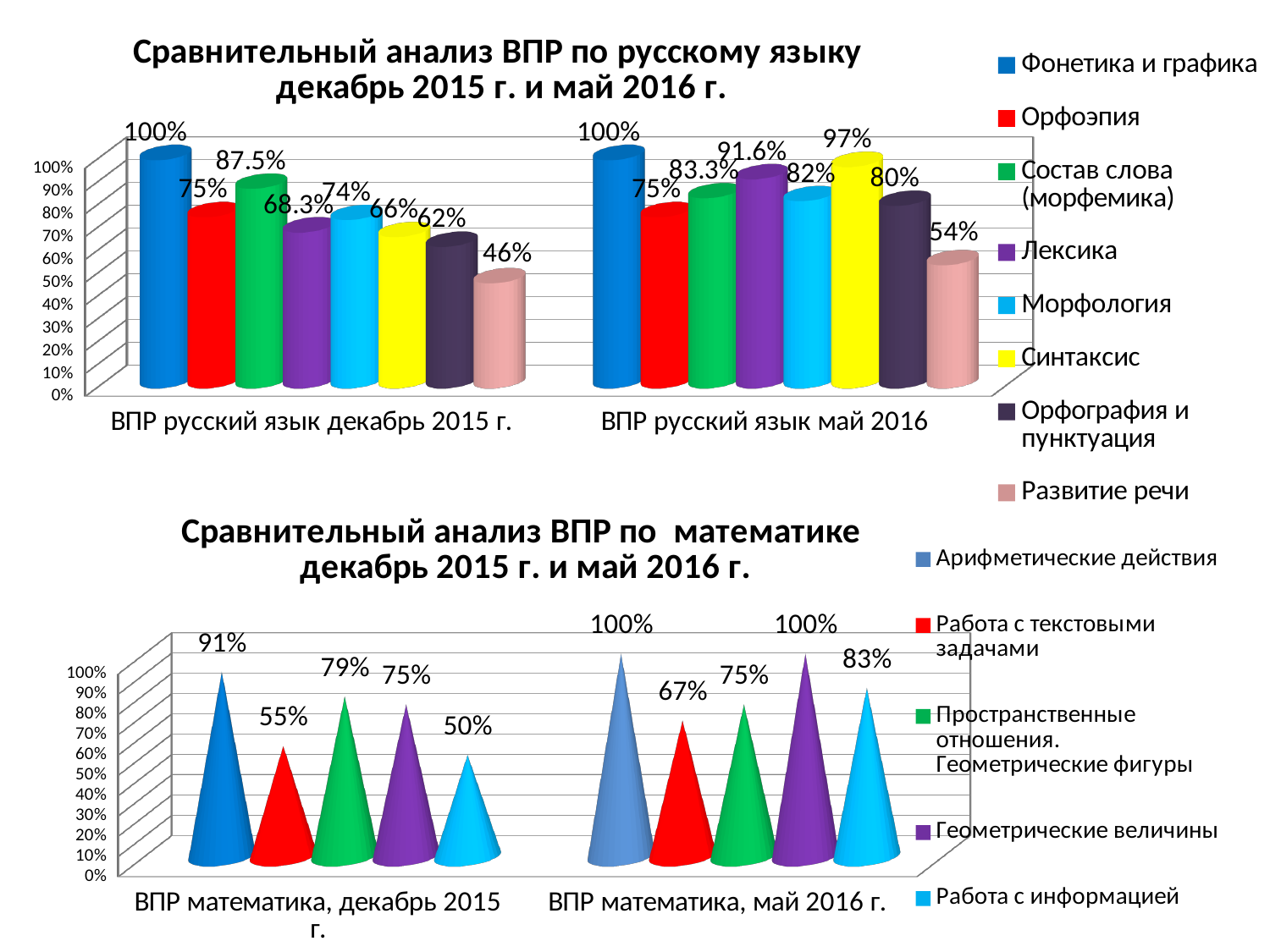
In the bottom chart (Сравнительный анализ ВПР по математике), what is the difference between Работа с информацией in май 2016 and in декабрь 2015? 33% In the bottom chart (Сравнительный анализ ВПР по математике), what is the value for Работа с текстовыми задачами in ВПР математика, декабрь 2015 г.? 55% In the top chart (Сравнительный анализ ВПР по русскому языку), what colour represents Синтаксис? Yellow In the bottom chart (Сравнительный анализ ВПР по математике), how many series does the legend list? 5 In the top chart (Сравнительный анализ ВПР по русскому языку), which series has the lowest value in ВПР русский язык май 2016? Развитие речи In the top chart (Сравнительный анализ ВПР по русскому языку), what is the value for Развитие речи in ВПР русский язык декабрь 2015 г.? 46% In the top chart (Сравнительный анализ ВПР по русскому языку), how many series does the legend list? 8 In the top chart (Сравнительный анализ ВПР по русскому языку), what is the difference between the Лексика values for май 2016 and декабрь 2015? 23.3% In the top chart (Сравнительный анализ ВПР по русскому языку), what is the value for Синтаксис in ВПР русский язык май 2016? 97% In the bottom chart (Сравнительный анализ ВПР по математике), which series has the lowest value in ВПР математика, май 2016 г.? Работа с текстовыми задачами In the bottom chart (Сравнительный анализ ВПР по математике), what type of chart is shown? Bar chart In the top chart (Сравнительный анализ ВПР по русскому языку), which is larger: Состав слова (морфемика) in декабрь 2015 or in май 2016? декабрь 2015